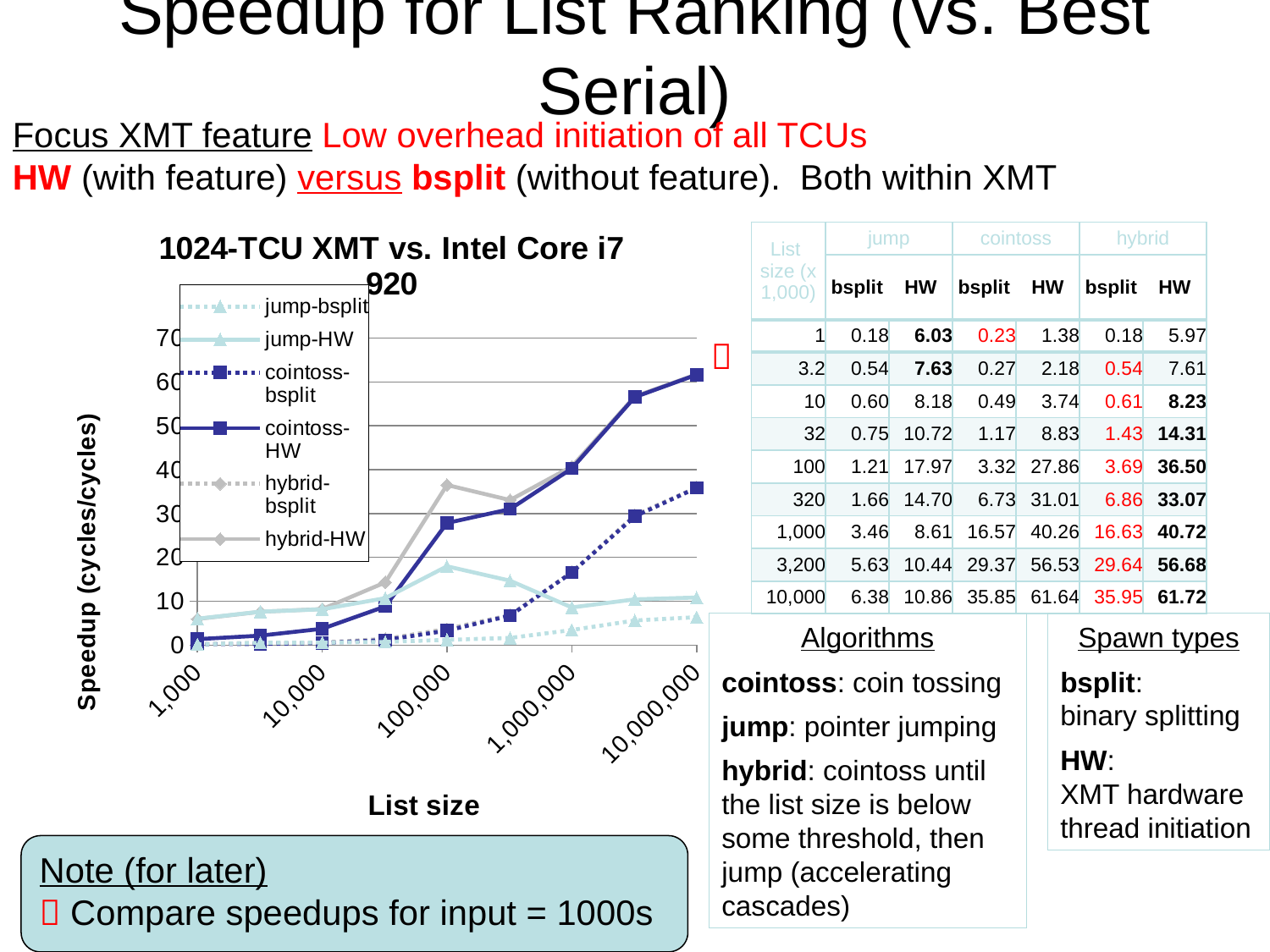
What kind of chart is shown on the slide? line chart How many series does the chart legend list? 6 Is the value for cointoss-HW at list size 1,000,000 greater or less than 30? greater What is the label on the chart's y axis? Speedup (cycles/cycles) What is the title of the chart? 1024-TCU XMT vs. Intel Core i7 920 Is the value for jump-HW at list size 100,000 greater or less than 20? less Does the cointoss-HW series rise or fall as list size increases along the x axis? rises How many data points does each series in the chart have? 9 According to the table, what is the cointoss HW speedup for list size 10,000 (x 1,000)? 61.64 According to the table, which is larger at list size 100 (x 1,000): the jump HW speedup or the cointoss HW speedup? cointoss HW According to the table, which algorithm/spawn type combination has the lowest speedup for list size 10,000 (x 1,000)? jump bsplit According to the table, what is the difference between the hybrid HW and hybrid bsplit speedups for list size 10,000 (x 1,000)? 25.77